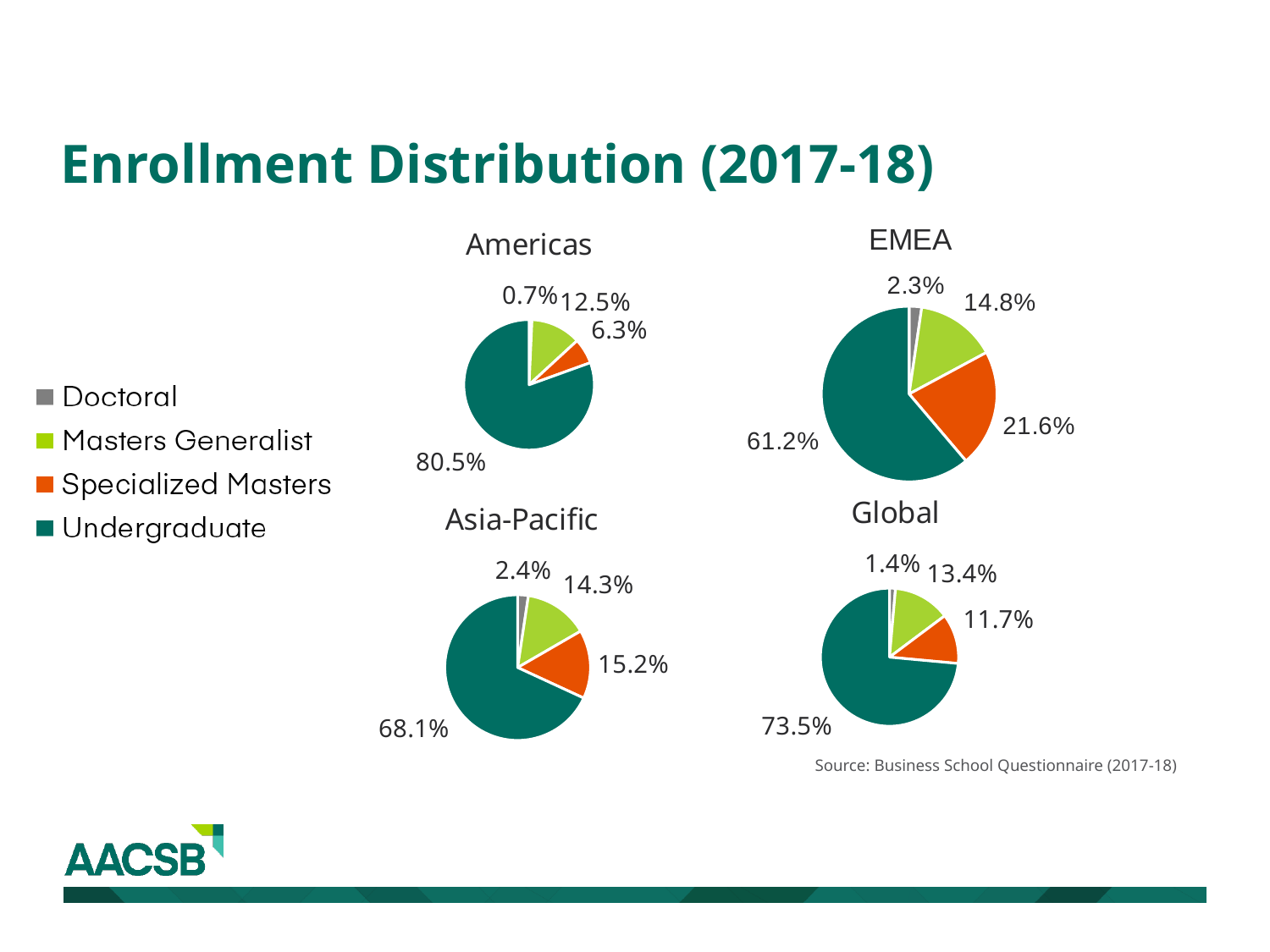
How many pie charts are shown on the slide? 4 How many series does the legend list? 4 What is the difference between the Undergraduate share in the Americas chart and the Undergraduate share in the EMEA chart? 19.3% In the EMEA chart, which category has the smallest share? Doctoral In the Global chart, which category has the largest share? Undergraduate What kind of chart is used for each region on this slide? Pie chart In the EMEA chart, what share of enrollment is Specialized Masters? 21.6% In the Americas chart, what is the difference between the Masters Generalist share and the Specialized Masters share? 6.2% In the Global chart, what share of enrollment is Doctoral? 1.4% In the Americas chart, what share of enrollment is Undergraduate? 80.5% In the Asia-Pacific chart, what share of enrollment is Masters Generalist? 14.3% In the Asia-Pacific chart, which is larger: Specialized Masters or Masters Generalist? Specialized Masters